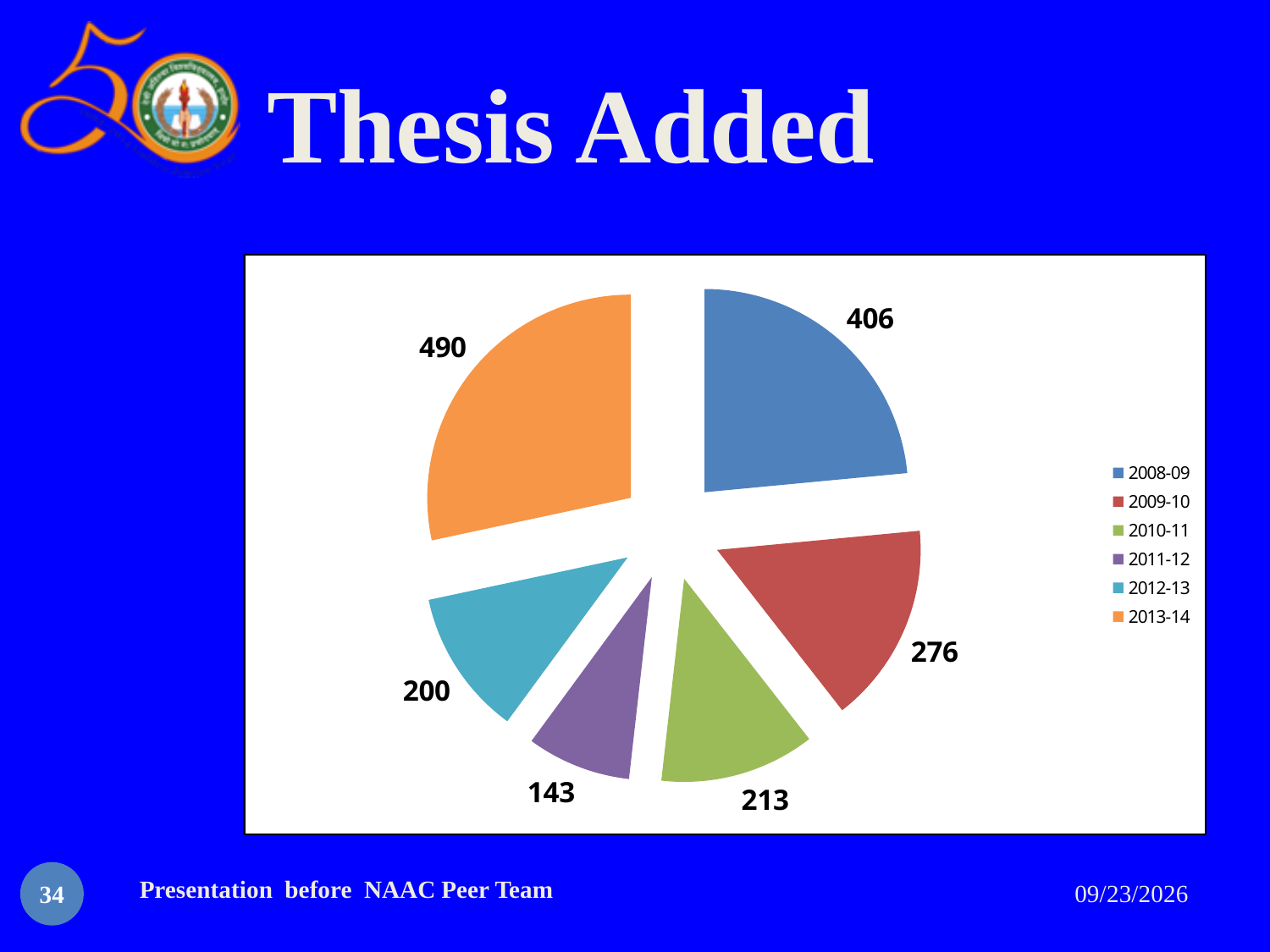
Which year has the largest slice? 2013-14 What is the value for 2011-12? 143 What is the title of the slide containing the chart? Thesis Added What is the value for 2008-09? 406 Which year has the smallest slice? 2011-12 What type of chart is shown on the slide? pie chart How many slices does the pie chart have? 6 What is the value for 2012-13? 200 What is the difference between the values for 2013-14 and 2008-09? 84 How many entries does the legend list? 6 What is the total of all the values in the pie chart? 1728 Which is larger, the value for 2009-10 or the value for 2010-11? 2009-10